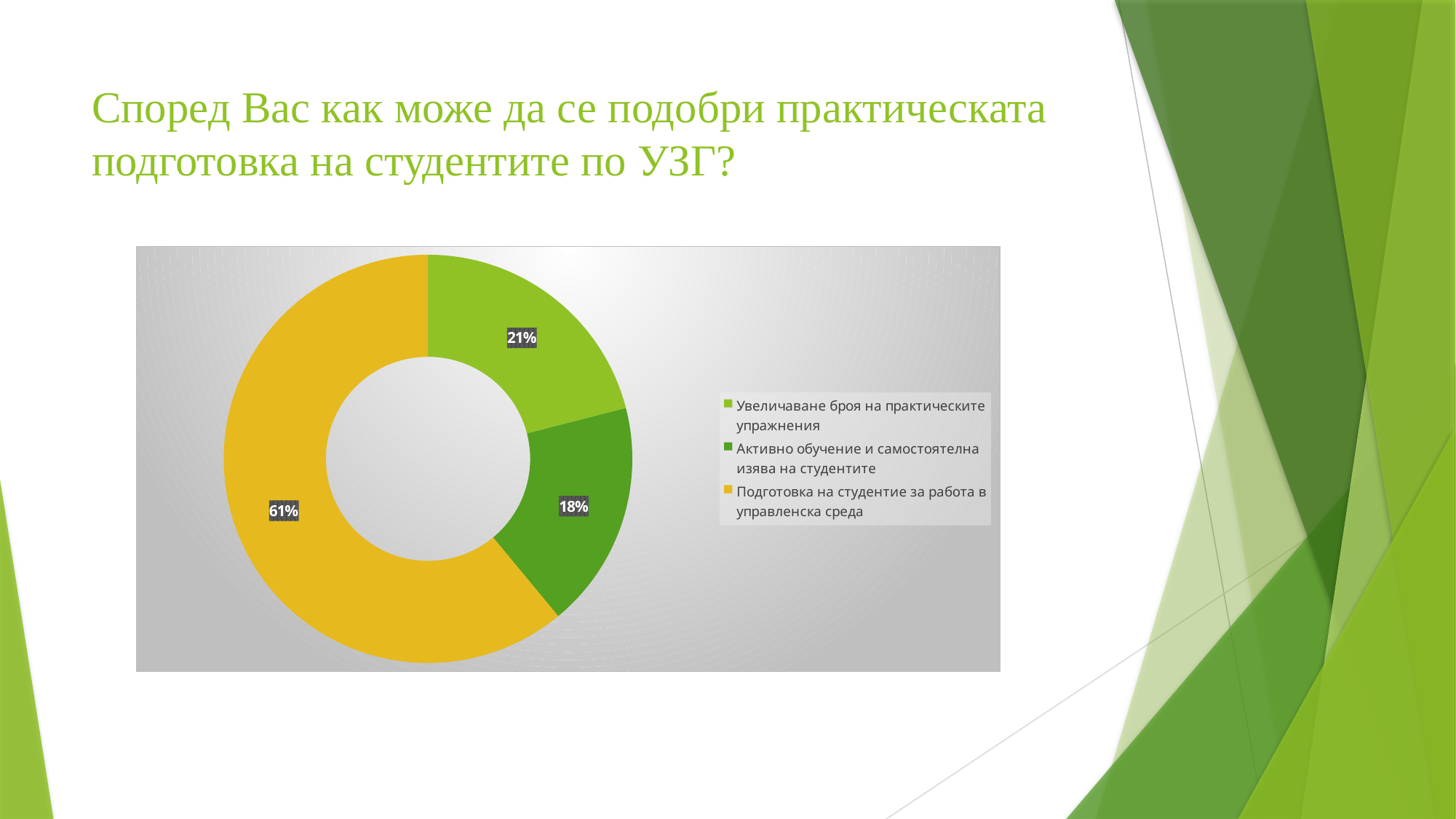
Which category has the smallest share of the chart? Активно обучение и самостоятелна изява на студентите What share of the chart does "Увеличаване броя на практическите упражнения" represent? 21% What is the difference in percentage points between "Увеличаване броя на практическите упражнения" and "Активно обучение и самостоятелна изява на студентите"? 3 What share of the chart does "Подготовка на студентие за работа в управленска среда" represent? 61% How many categories does the chart show? 3 What colour is the slice for "Подготовка на студентие за работа в управленска среда"? Yellow Which is larger: the share for "Увеличаване броя на практическите упражнения" or for "Активно обучение и самостоятелна изява на студентите"? Увеличаване броя на практическите упражнения What is the difference in percentage points between the largest and smallest slices? 43 What share of the chart does "Активно обучение и самостоятелна изява на студентите" represent? 18% What kind of chart is shown on the slide? Doughnut (pie) chart Which category has the largest share of the chart? Подготовка на студентие за работа в управленска среда What is the combined share of the two green slices? 39%